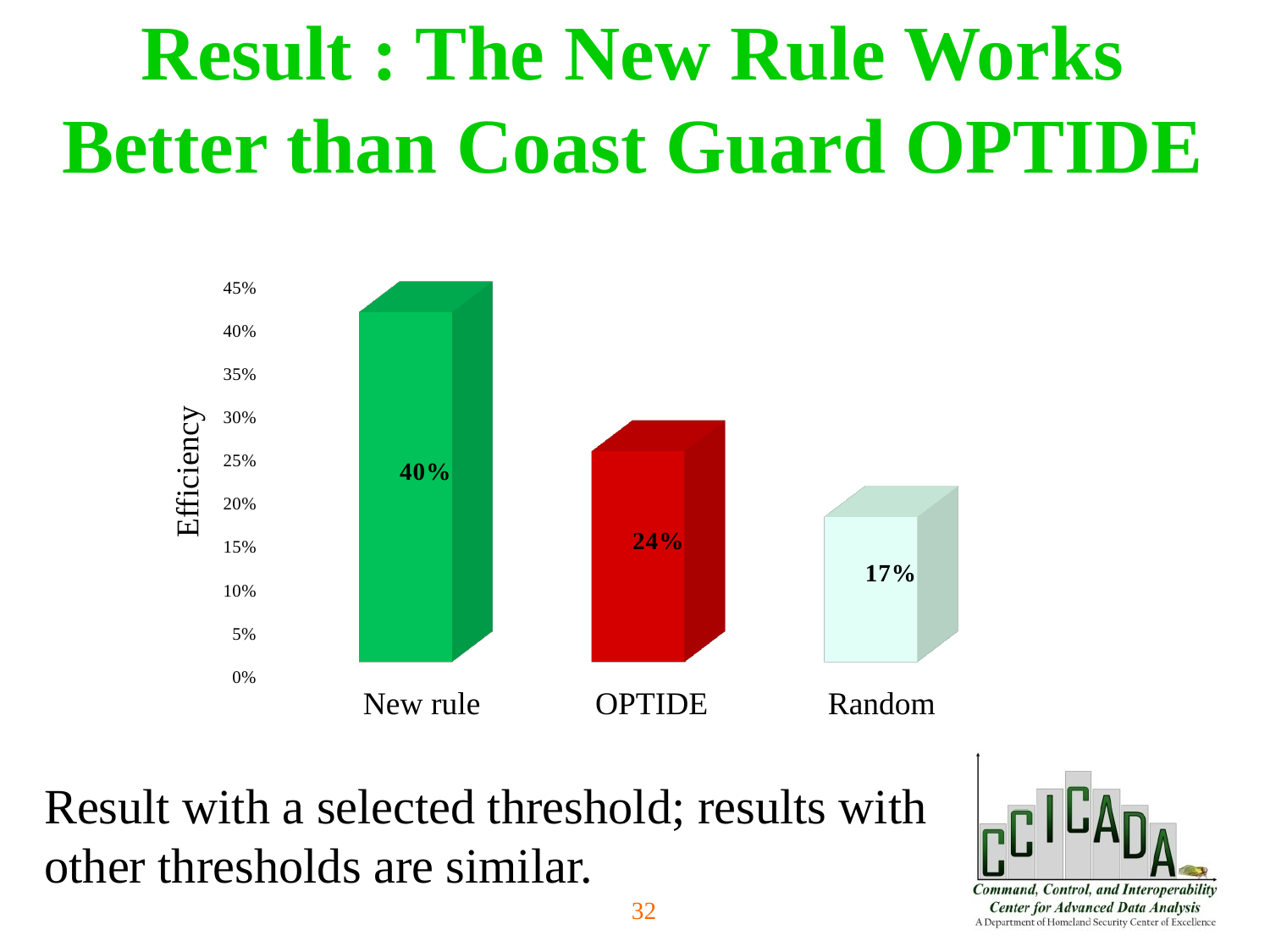
What is the efficiency value for Random? 17% What is the efficiency value for New rule? 40% Is the efficiency for New rule greater or less than 35%? greater What is the efficiency value for OPTIDE? 24% What is the difference in efficiency between New rule and OPTIDE? 16% Which category has the highest efficiency? New rule What is the difference in efficiency between OPTIDE and Random? 7% Which category has the lowest efficiency? Random Which has a higher efficiency, OPTIDE or Random? OPTIDE What kind of chart is shown on the slide? Bar chart How many categories are shown in the chart? 3 What is the label of the vertical axis? Efficiency